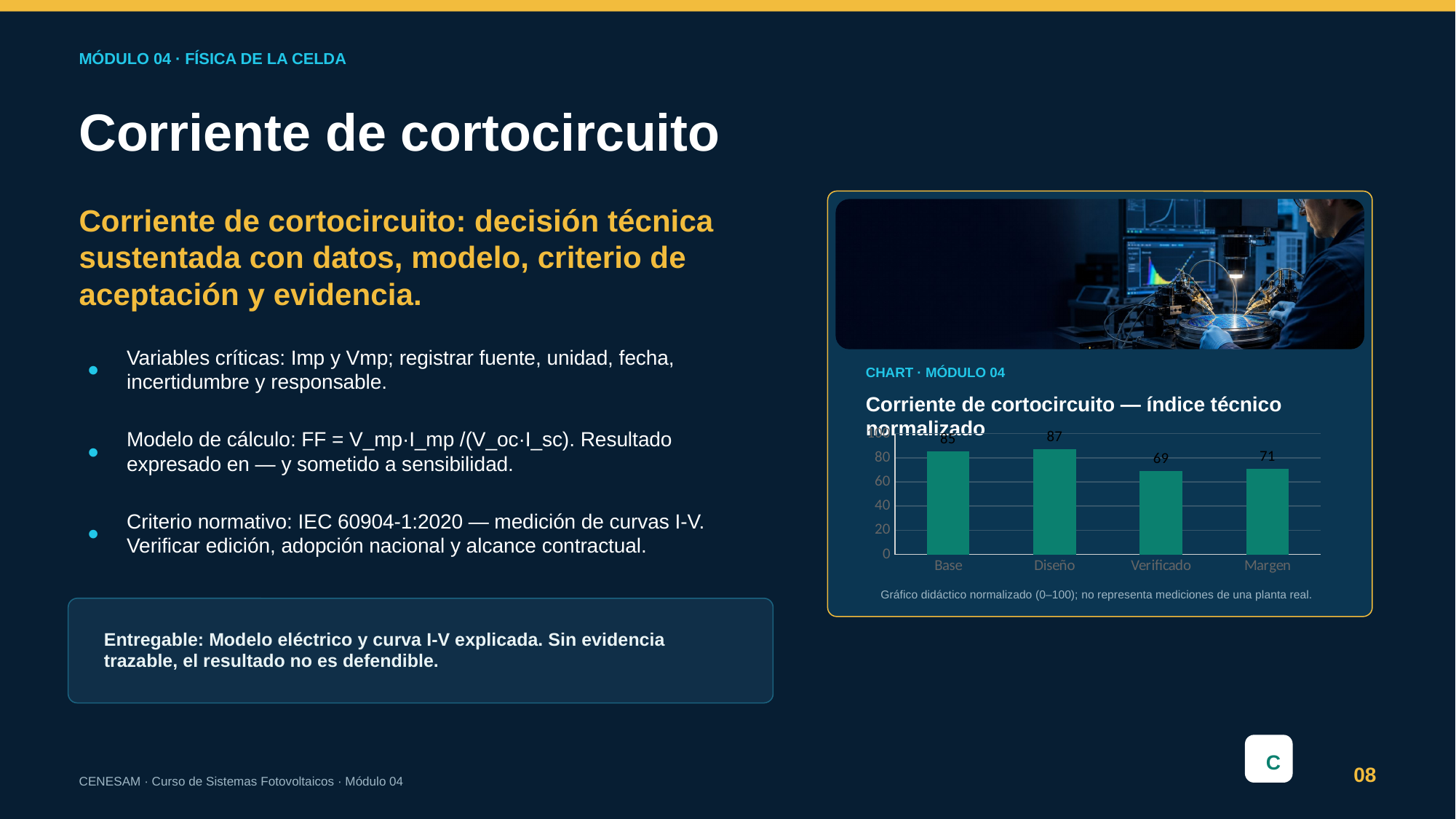
What is the value for Base? 85 Which is larger, the value for Base or the value for Margen? Base What is the value for Margen? 71 How many categories are shown on the x axis? 4 Which category has the highest value? Diseño What is the title of the chart? Corriente de cortocircuito — índice técnico normalizado What is the difference between the values for Diseño and Verificado? 18 What kind of chart is shown on the slide? bar chart What is the value for Diseño? 87 Is the value for Verificado greater or less than 80? less What is the value for Verificado? 69 Which category has the lowest value? Verificado